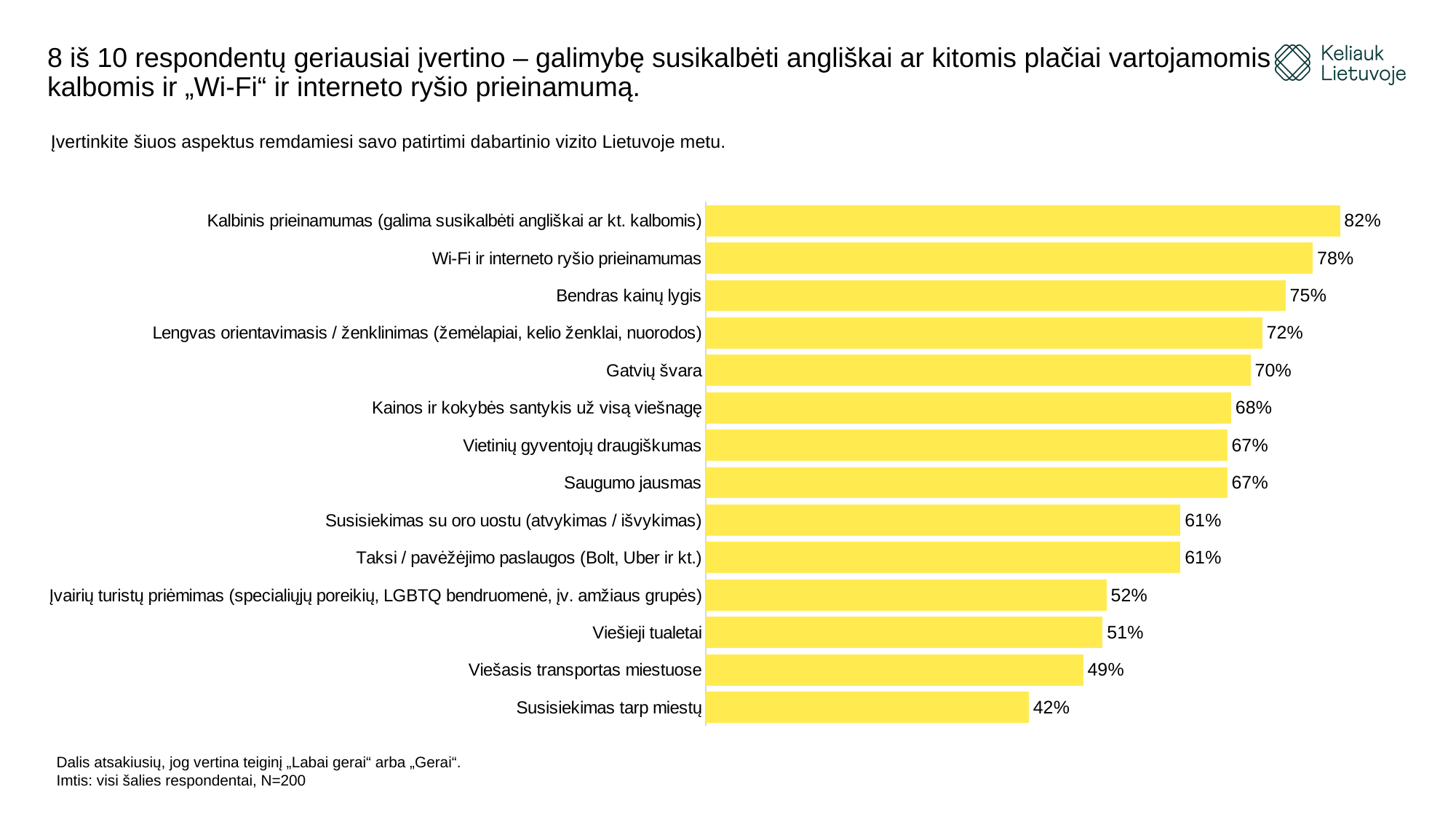
Which category has the highest value? Kalbinis prieinamumas (galima susikalbėti angliškai ar kt. kalbomis) Which is larger: the value for "Kainos ir kokybės santykis už visą viešnagę" or the value for "Įvairių turistų priėmimas (specialiųjų poreikių, LGBTQ bendruomenė, įv. amžiaus grupės)"? Kainos ir kokybės santykis už visą viešnagę What is the difference between the values for "Bendras kainų lygis" and "Viešasis transportas miestuose"? 26% Which category has the lowest value? Susisiekimas tarp miestų What colour are the bars on the chart? Yellow What is the value for "Taksi / pavėžėjimo paslaugos (Bolt, Uber ir kt.)"? 61% How many categories are shown on the chart? 14 What kind of chart is shown on the slide? Bar chart What is the value for "Gatvių švara"? 70% What is the value for "Wi-Fi ir interneto ryšio prieinamumas"? 78% What is the value for "Viešieji tualetai"? 51% What is the difference between the highest and lowest values on the chart? 40%